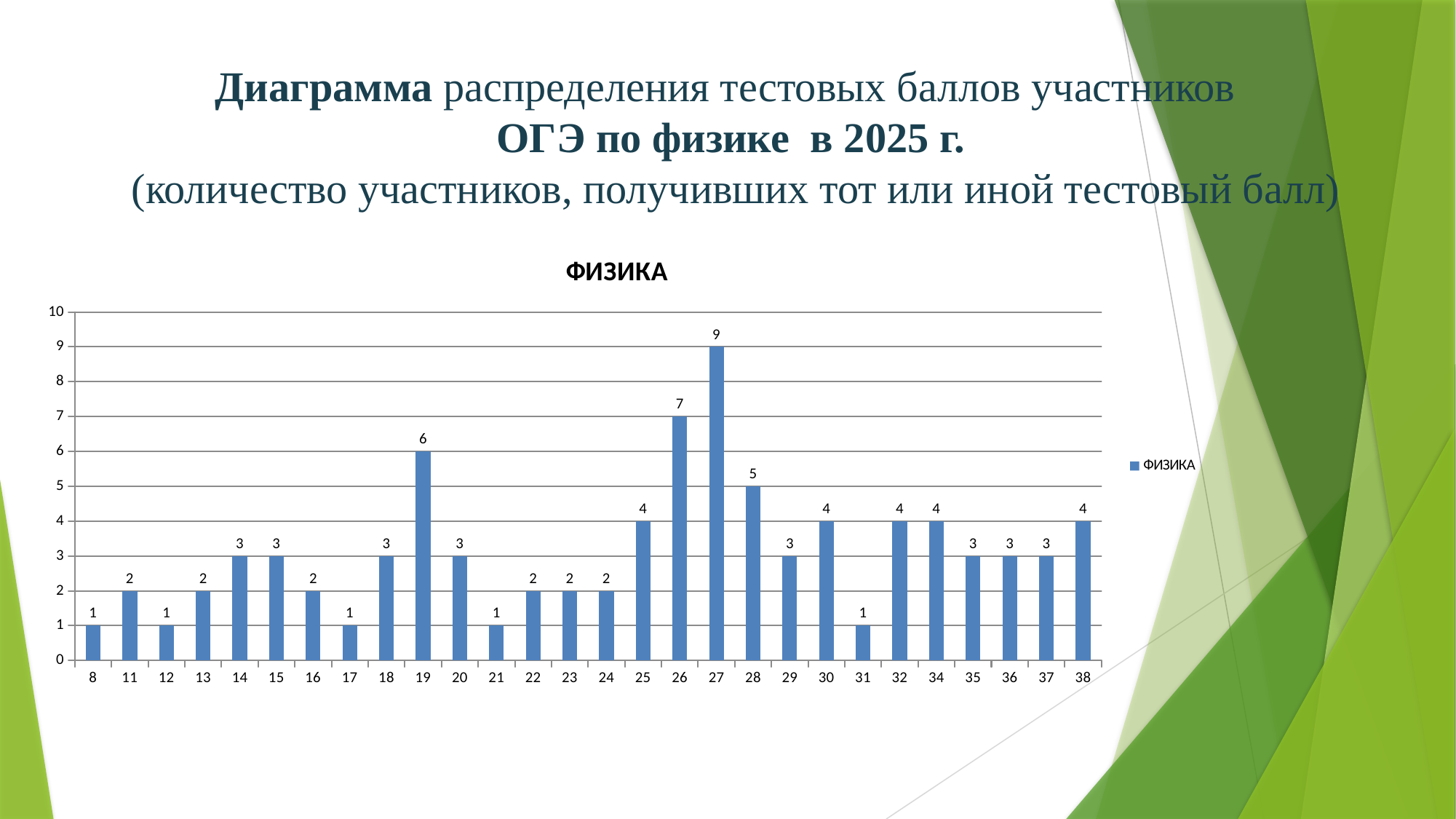
Which is larger, the value for score 25 or the value for score 28? 28 Is the value for score 26 greater or less than 5? greater What is the value for score 28? 5 What kind of chart is shown on the slide? bar chart How many series does the legend list? 1 What is the difference between the values for scores 27 and 26? 2 What is the difference between the values for scores 19 and 20? 3 What is the value for score 27? 9 What is the title of the chart? ФИЗИКА Which score has the highest number of participants? 27 What is the value for score 19? 6 How many score categories are shown on the x axis? 28